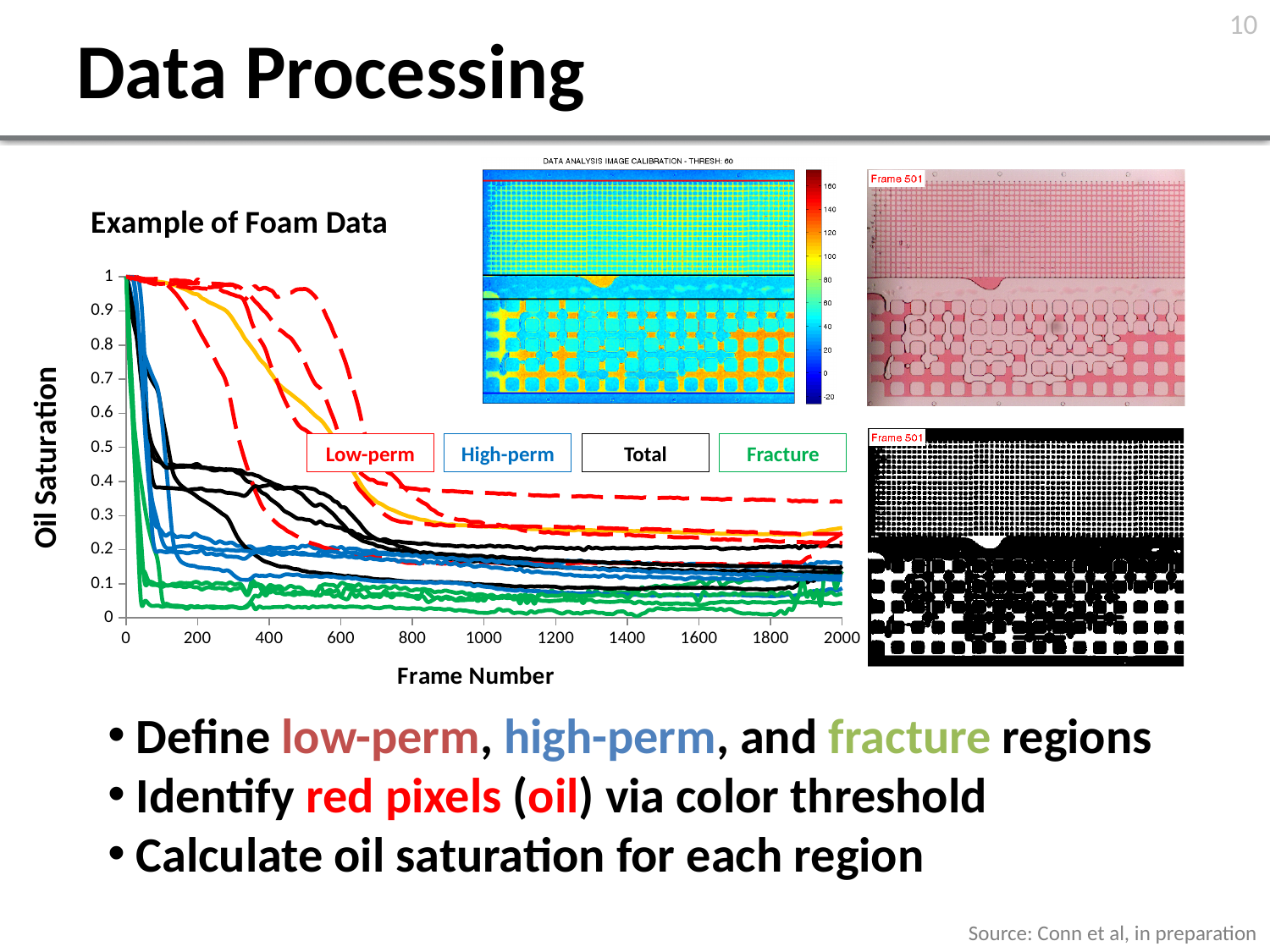
In the 'Example of Foam Data' chart, do the oil saturation values rise or fall as the frame number increases? fall In the 'Example of Foam Data' chart, which series has the highest oil saturation at frame 2000? Low-perm In the 'Example of Foam Data' chart, which series has the lowest oil saturation at frame 2000? Fracture What kind of chart is the 'Example of Foam Data' chart? line chart In the 'Example of Foam Data' chart, is the oil saturation of the High-perm series at frame 1000 greater or less than 0.3? less What are the four series named in the legend of the 'Example of Foam Data' chart? Low-perm, High-perm, Total, Fracture How many series does the legend of the 'Example of Foam Data' chart list? 4 What is the label of the x axis of the 'Example of Foam Data' chart? Frame Number In the 'Example of Foam Data' chart, is the oil saturation of the Fracture series at frame 2000 greater or less than 0.1? less In the 'Example of Foam Data' chart, at frame 2000, which series has the larger oil saturation: Low-perm or Fracture? Low-perm In the 'Example of Foam Data' chart, what is the oil saturation of the series at frame 0? 1